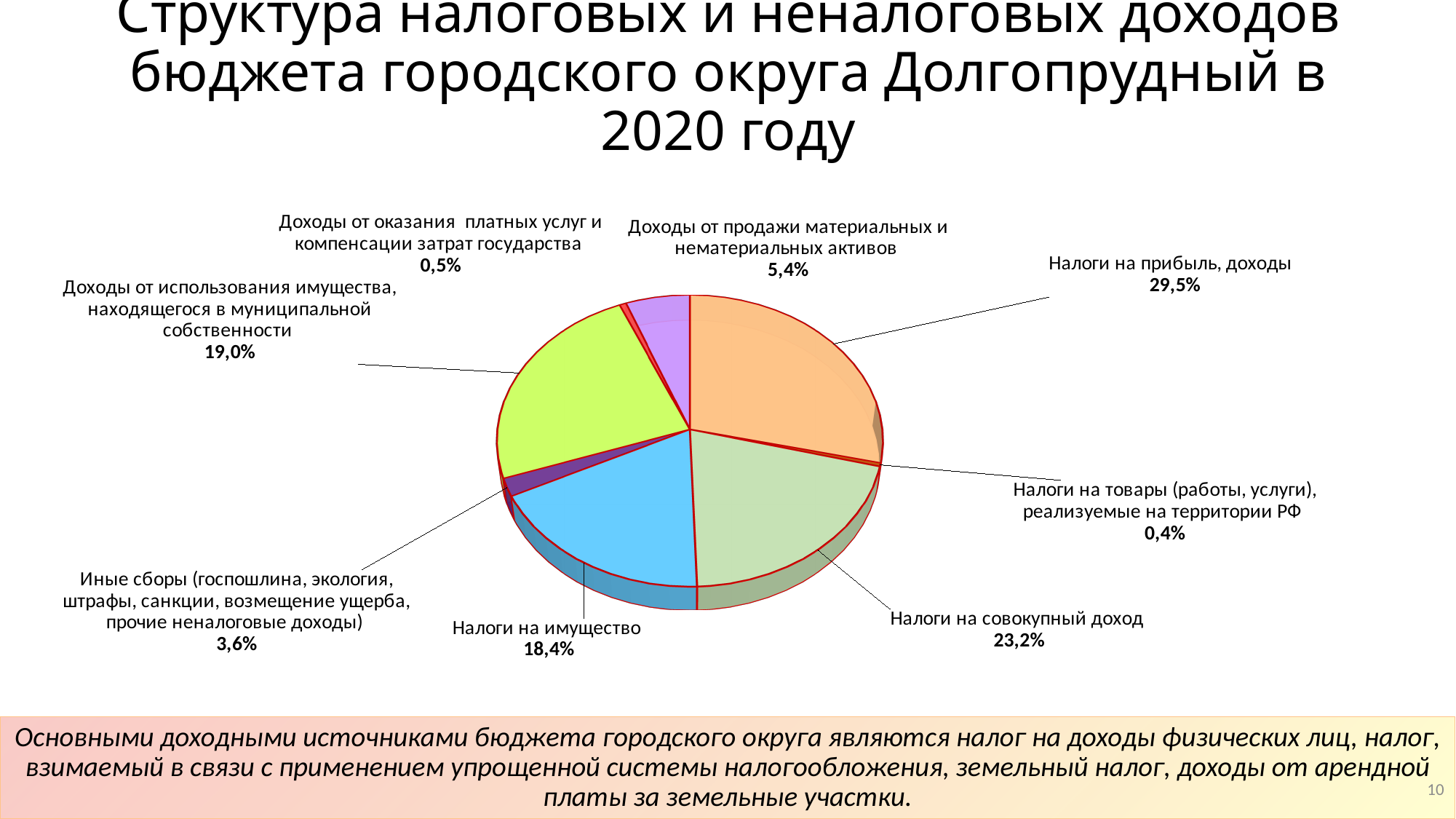
What percentage is shown for «Налоги на имущество»? 18,4% How many categories (slices) does the pie chart have? 8 What is the difference in percentage points between «Налоги на прибыль, доходы» and «Налоги на совокупный доход»? 6,3 Which category has the smallest slice of the pie? Налоги на товары (работы, услуги), реализуемые на территории РФ What share is shown for «Доходы от использования имущества, находящегося в муниципальной собственности»? 19,0% What kind of chart is shown on the slide? pie chart Which is larger: «Налоги на имущество» or «Доходы от использования имущества, находящегося в муниципальной собственности»? Доходы от использования имущества, находящегося в муниципальной собственности What is the value shown for «Налоги на совокупный доход»? 23,2% What share of the budget revenue comes from «Налоги на прибыль, доходы»? 29,5% What is the value shown for «Иные сборы (госпошлина, экология, штрафы, санкции, возмещение ущерба, прочие неналоговые доходы)»? 3,6% What is the value for «Доходы от продажи материальных и нематериальных активов»? 5,4% Which category has the largest slice of the pie? Налоги на прибыль, доходы